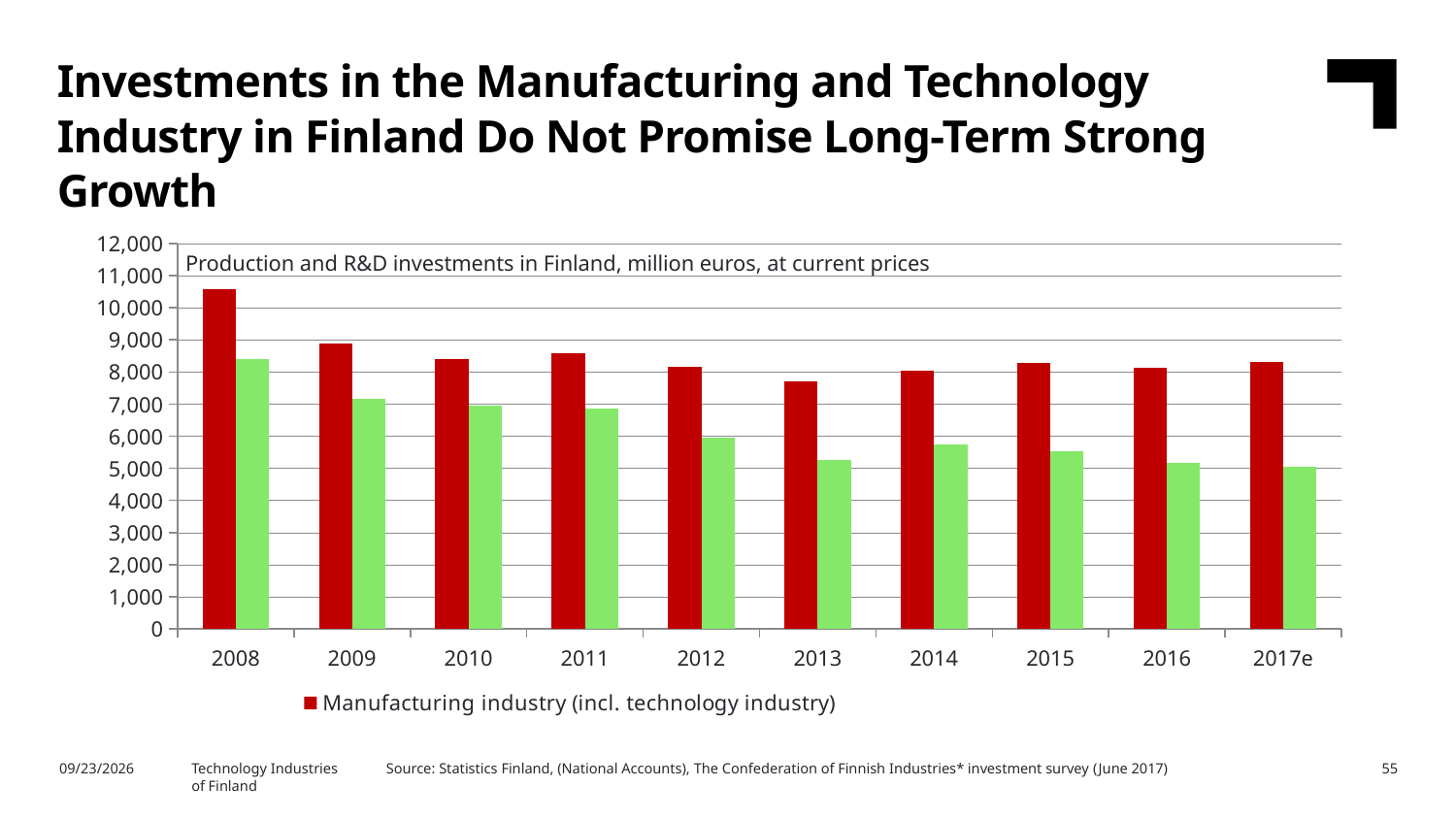
Is the Manufacturing industry (incl. technology industry) value for 2008 greater or less than 10,000? greater What is the text shown inside the chart describing what is plotted? Production and R&D investments in Finland, million euros, at current prices Is the Manufacturing industry (incl. technology industry) value for 2013 greater or less than 8,000? less In which year is the Manufacturing industry (incl. technology industry) value highest? 2008 How many series does the chart's legend list? 1 Do the green bars generally rise or fall from 2008 to 2017e? fall How many years are shown on the x axis of the chart? 10 Is the green bar for 2017e greater or less than 6,000? less What colour represents Manufacturing industry (incl. technology industry) in the legend? red What kind of chart is shown on the slide? bar chart In which year is the Manufacturing industry (incl. technology industry) value lowest? 2013 Which year has the larger Manufacturing industry (incl. technology industry) value, 2008 or 2009? 2008